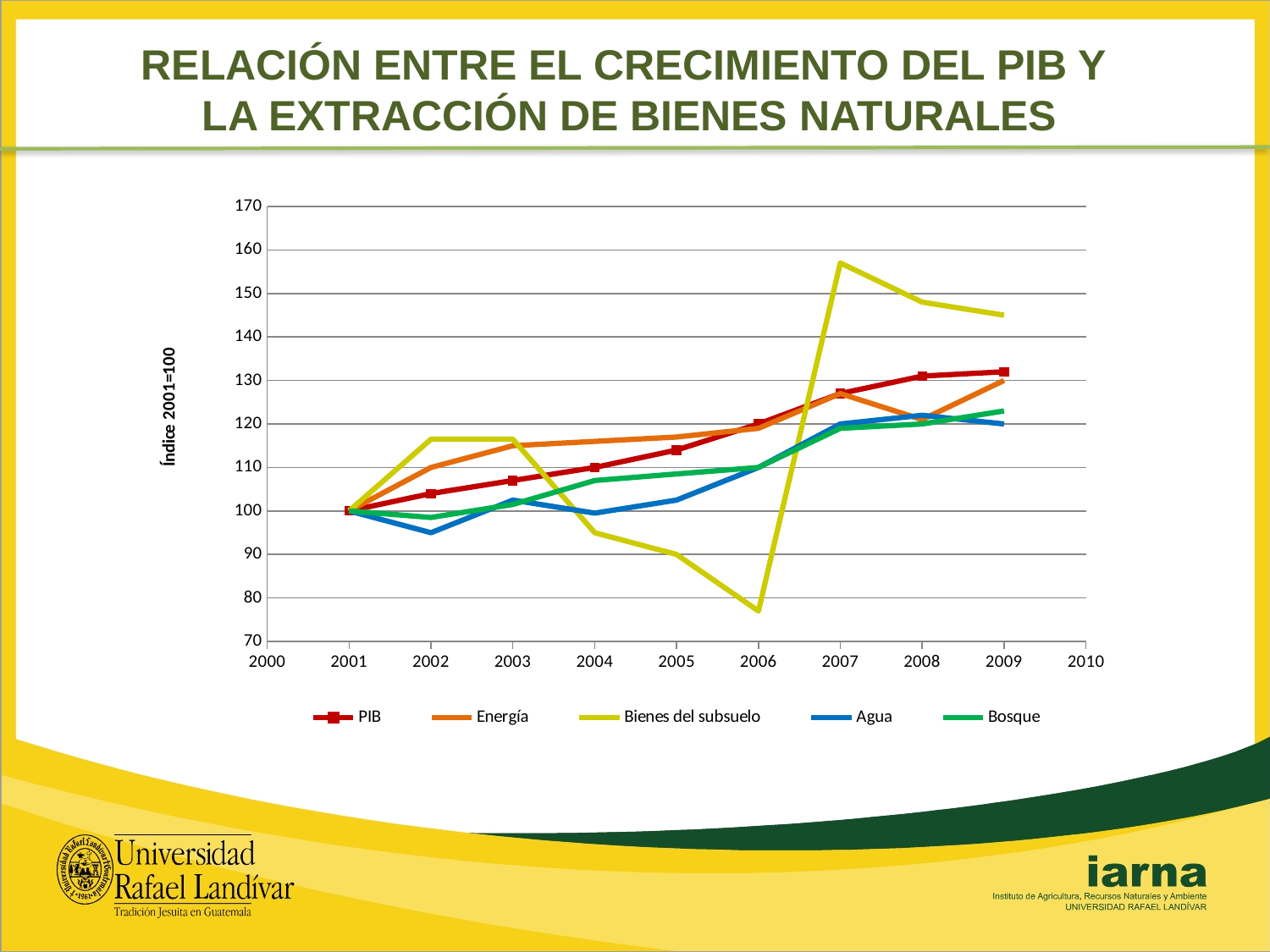
Is the value for Bienes del subsuelo in 2007 greater or less than 150? greater Which series has the lowest value in 2006? Bienes del subsuelo In 2009, which is larger: the value for PIB or the value for Agua? PIB Which series has the highest value in 2007? Bienes del subsuelo Does the PIB series rise or fall from 2001 to 2009? rise What kind of chart is shown on the slide? line chart Which series has the lowest value in 2002? Agua What is the label on the vertical axis? Índice 2001=100 What is the value of the PIB series in 2001? 100 Is the value for Bienes del subsuelo in 2006 greater or less than 80? less How many series does the legend list? 5 Is the value for Agua in 2002 greater or less than 100? less